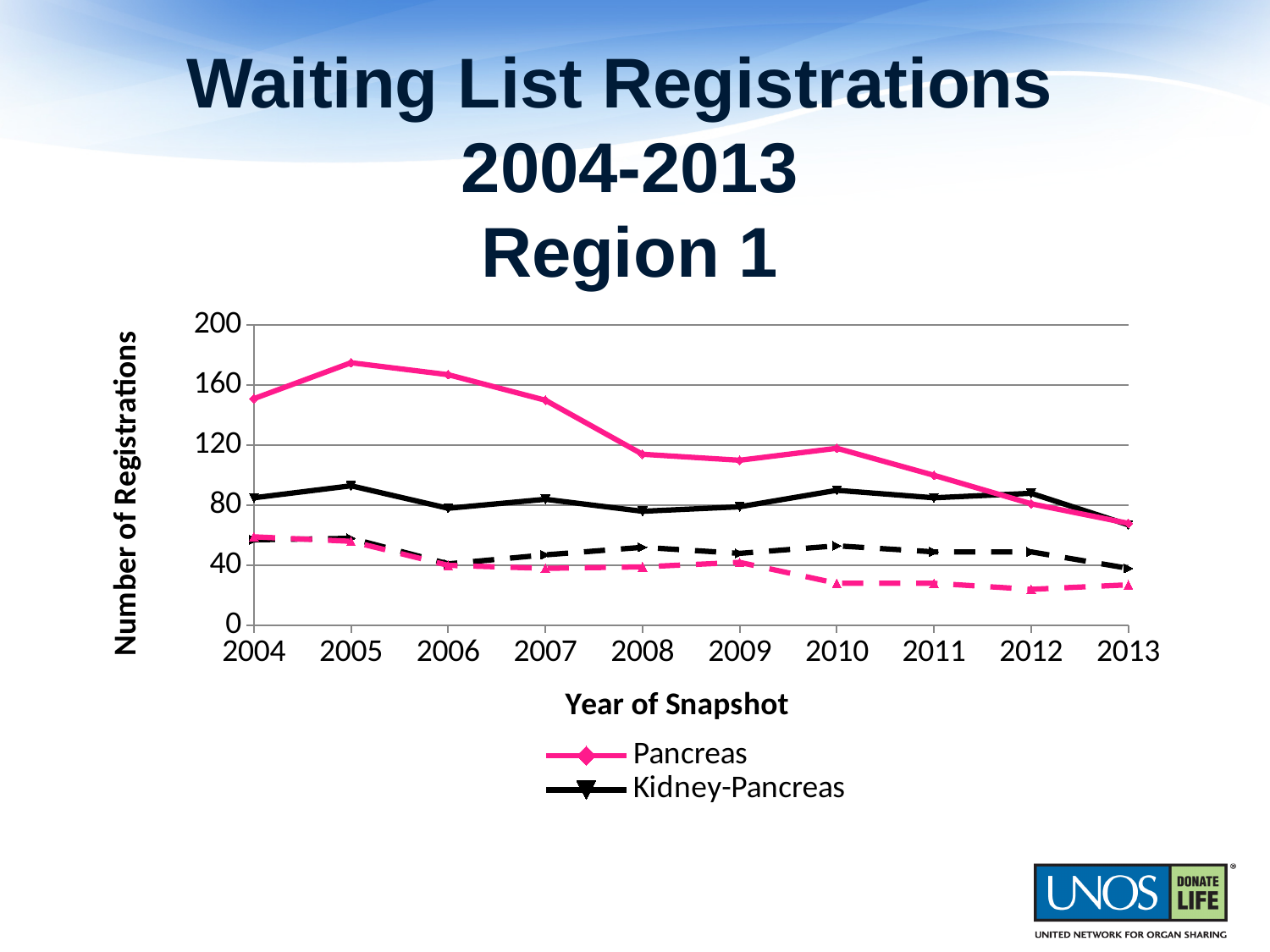
Which series has the larger value in 2005, Pancreas or Kidney-Pancreas? Pancreas In which year is the Pancreas series at its highest? 2005 Is the Pancreas value for 2013 greater or less than 80? less What kind of chart is shown on the slide? line chart Does the Pancreas series overall rise or fall from 2005 to 2013? fall In which year is the Pancreas series at its lowest? 2013 Is the Kidney-Pancreas value for 2005 greater or less than 80? greater Is the Pancreas value for 2008 greater or less than 120? less How many years are shown on the x axis? 10 How many series does the legend list? 2